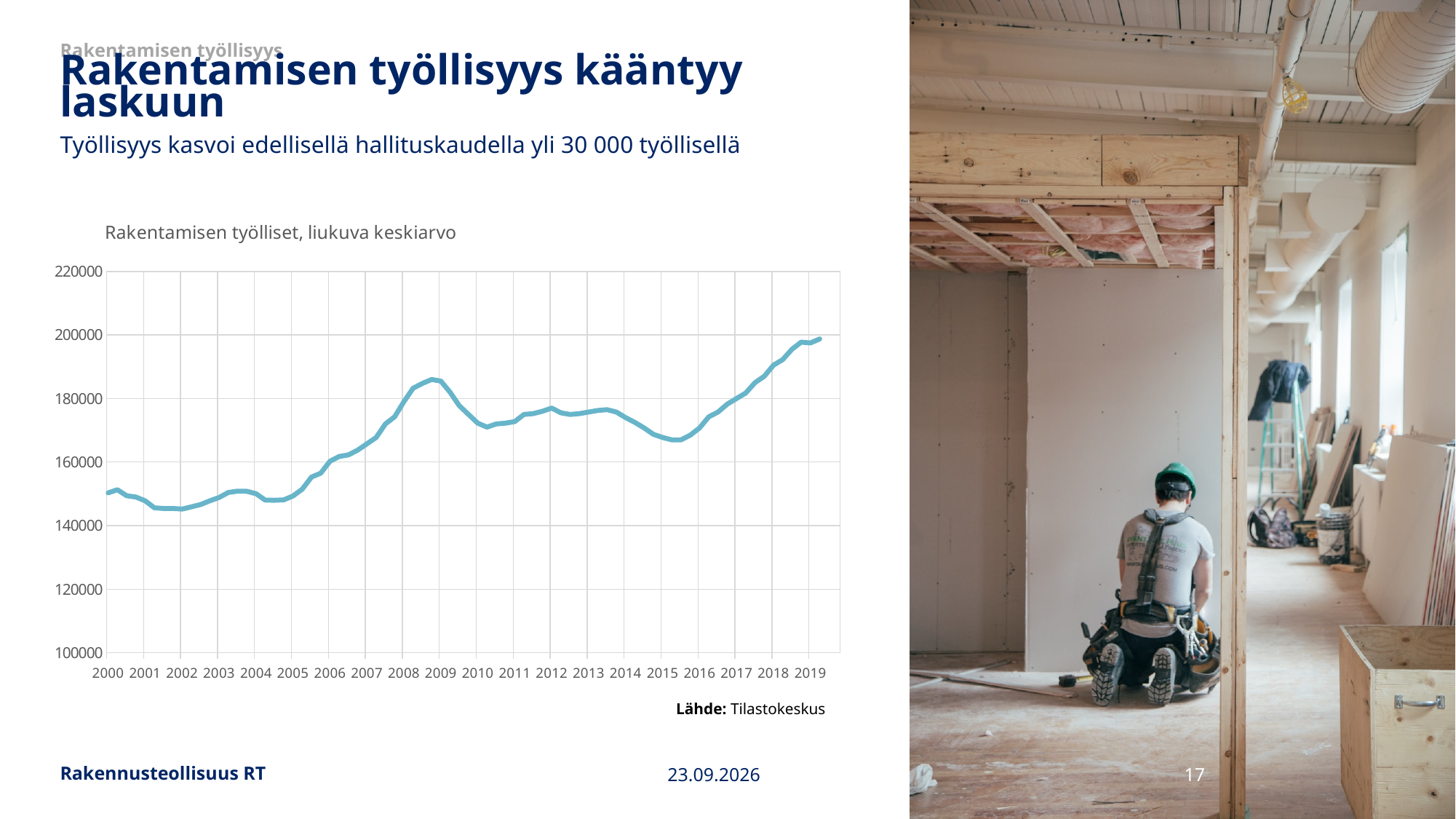
What source is given for the chart data? Tilastokeskus Is the value at the start of 2002 greater or less than 160000? less What is the highest value shown on the y axis of the chart? 220000 What kind of chart is shown on the slide? line chart Overall, do the values rise or fall from 2000 to 2019? rise Is the value at the start of 2015 greater or less than 180000? less Is the value at the start of 2009 greater or less than 180000? greater Which is higher, the value at the start of 2019 or the value at the start of 2009? 2019 Which is higher, the value at the start of 2002 or the value at the start of 2008? 2008 What is the title of the chart? Rakentamisen työlliset, liukuva keskiarvo How many years are labelled on the x axis of the chart? 20